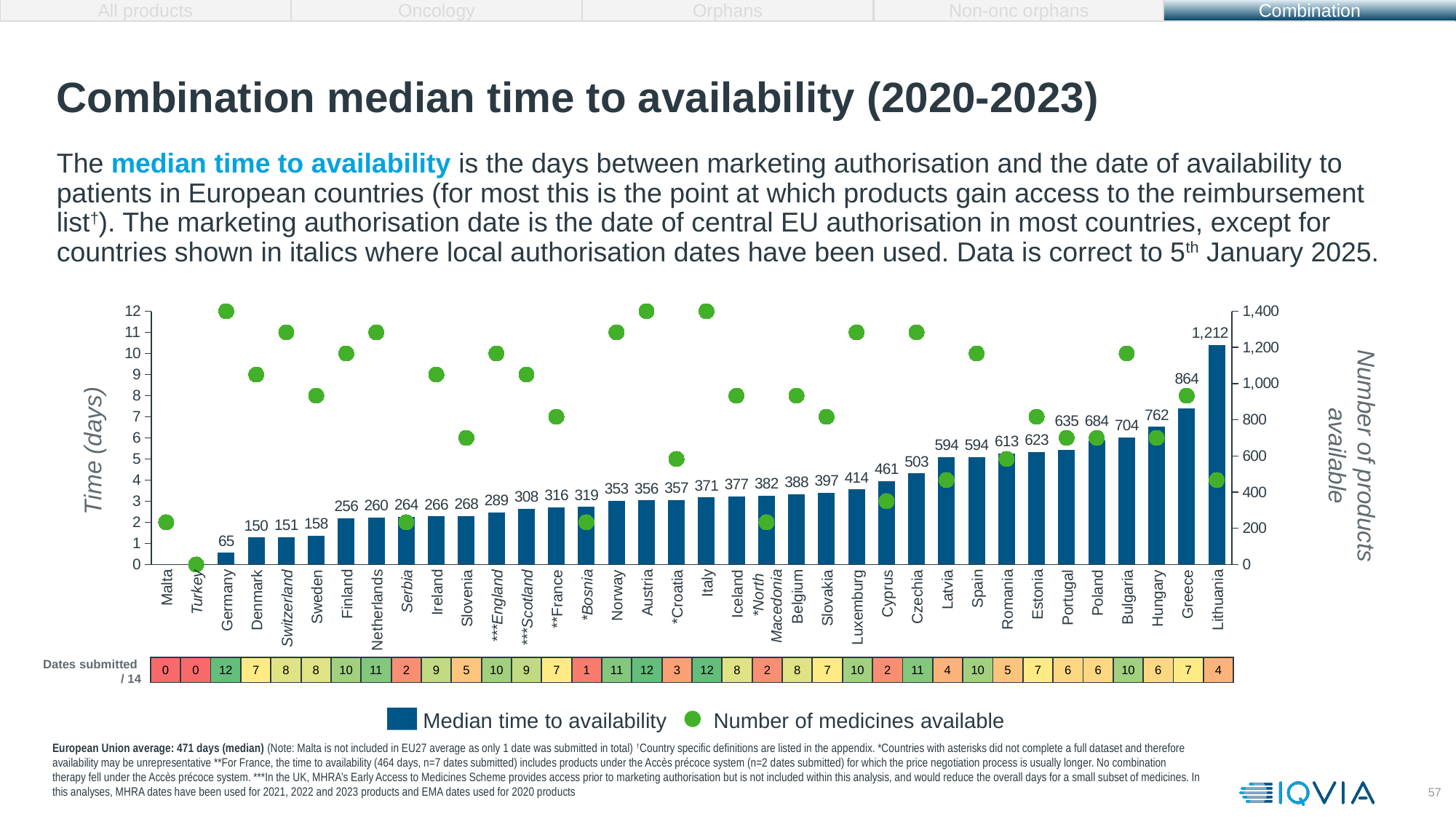
What is the difference in median time to availability between Greece and Hungary? 102 How many medicines are available in Turkey according to the green dot? 0 How many series does the legend list? 2 Which has a longer median time to availability, Poland or Portugal? Poland Which country has the highest median time to availability? Lithuania How many medicines are available in Germany according to the green dot? 12 Among the countries with a bar shown, which has the lowest median time to availability? Germany What is the median time to availability for Czechia? 503 What is the median time to availability for Germany? 65 What is the median time to availability for Lithuania? 1,212 What kind of chart is used to show the median time to availability? bar chart Do the median time to availability bars rise or fall from left to right across the countries? rise